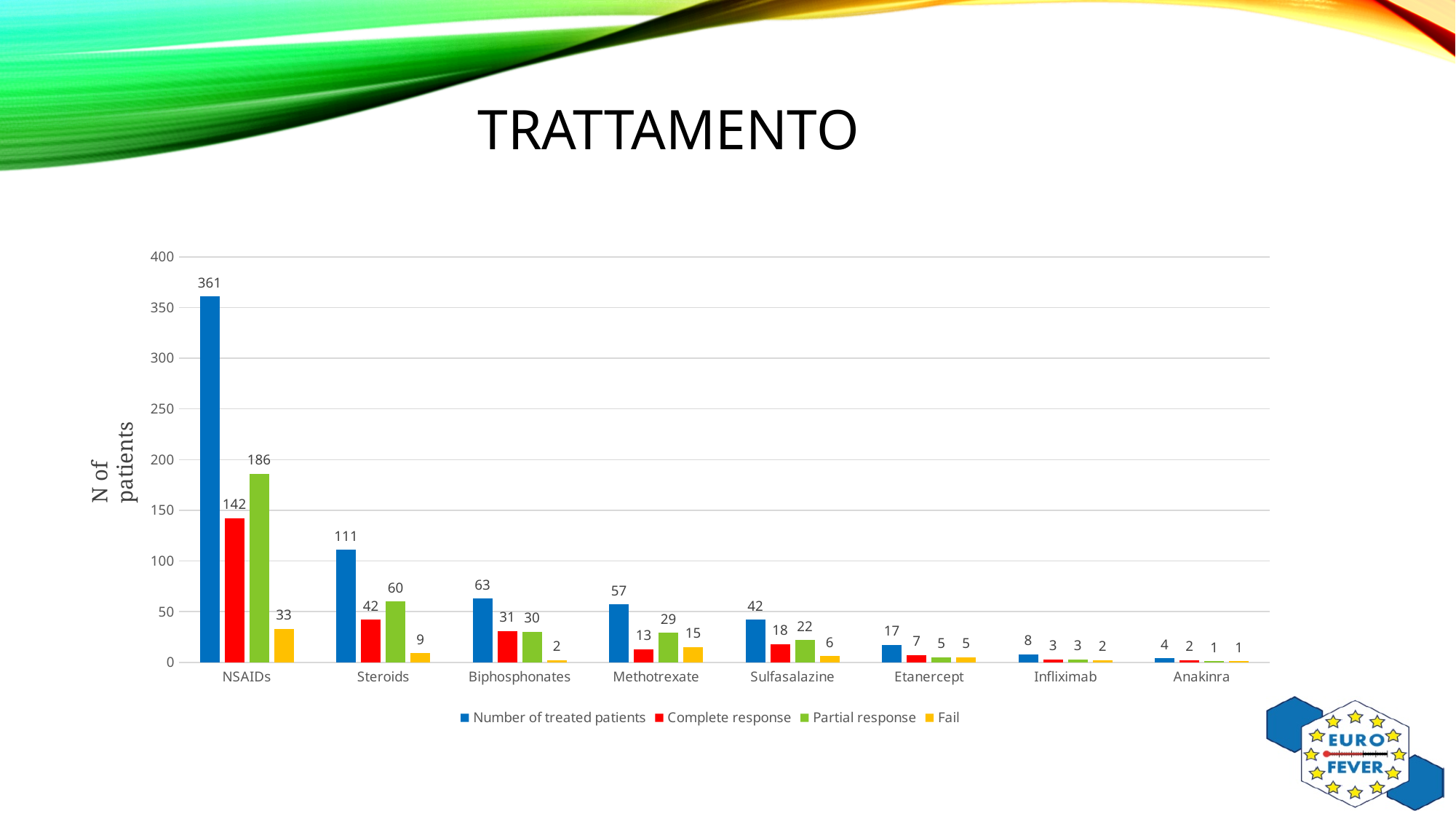
Which treatment has the lowest number of treated patients? Anakinra What kind of chart is shown on the slide? Bar chart What is the label of the vertical axis? N of patients What is the Partial response value for Methotrexate? 29 What is the Fail value for Sulfasalazine? 6 Which treatment has the highest number of treated patients? NSAIDs How many treatment categories are shown on the x axis? 8 What is the Complete response value for Steroids? 42 How many series does the legend list? 4 What is the number of treated patients for NSAIDs? 361 What is the difference between the Partial response and Complete response values for NSAIDs? 44 Which is larger for Biphosphonates: Complete response or Partial response? Complete response